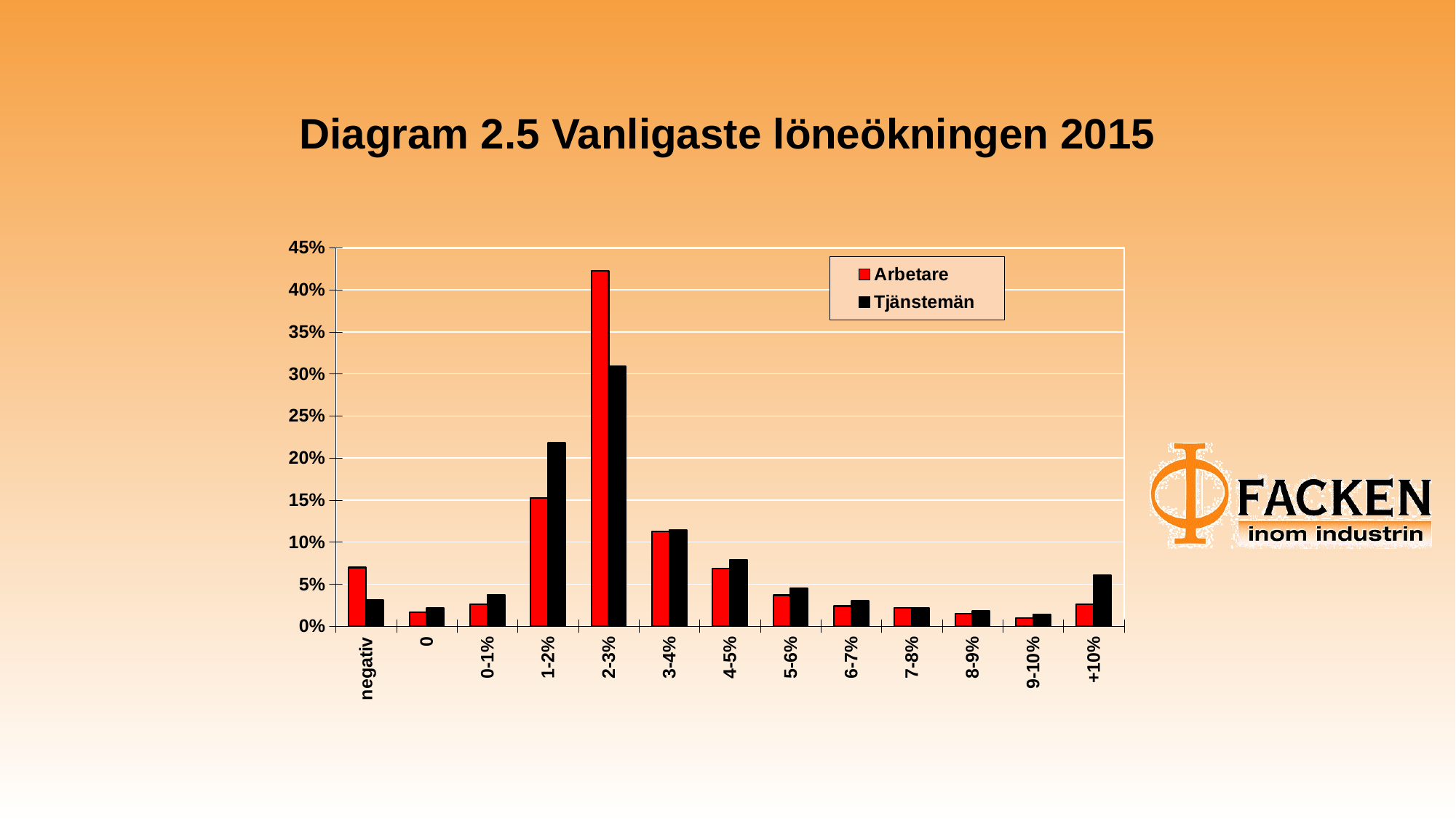
In the +10% category, which series has the larger value, Arbetare or Tjänstemän? Tjänstemän What kind of chart is shown on the slide? bar chart What is the title of the chart? Diagram 2.5 Vanligaste löneökningen 2015 Which category has the highest value for Tjänstemän? 2-3% Is the value for Tjänstemän in the 2-3% category greater or less than 30%? greater Which category has the highest value for Arbetare? 2-3% In the 1-2% category, which series has the larger value, Arbetare or Tjänstemän? Tjänstemän How many series does the legend list? 2 Is the value for Arbetare in the negativ category greater or less than 5%? greater How many categories are shown on the x axis? 13 Is the value for Tjänstemän in the 1-2% category greater or less than 20%? greater